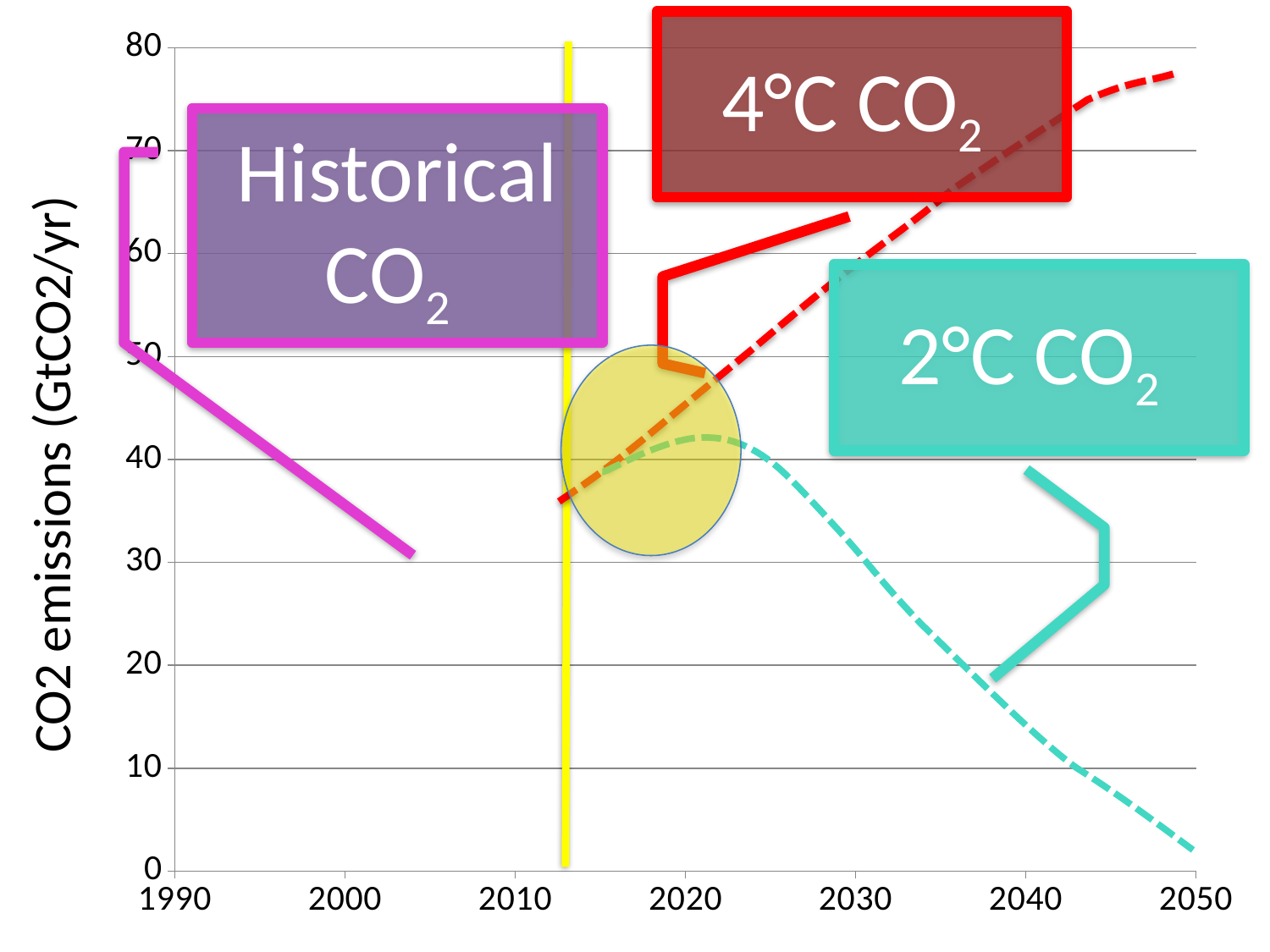
Does the 2°C CO2 series rise or fall between 2025 and 2050? fall What kind of chart is shown on the slide? line chart In 2050, which series has the higher value, 4°C CO2 or 2°C CO2? 4°C CO2 Does the 4°C CO2 series rise or fall between 2020 and 2050? rise How many CO2 series are labelled on the chart? 3 Is the value of the 4°C CO2 series in 2050 greater or less than 70? greater Which series is drawn as a red dashed line? 4°C CO2 What is the last year shown on the x axis? 2050 Is the value of the 2°C CO2 series in 2050 greater or less than 10? less What is the label of the y axis? CO2 emissions (GtCO2/yr) Is the value of the 2°C CO2 series in 2030 greater or less than 40? less